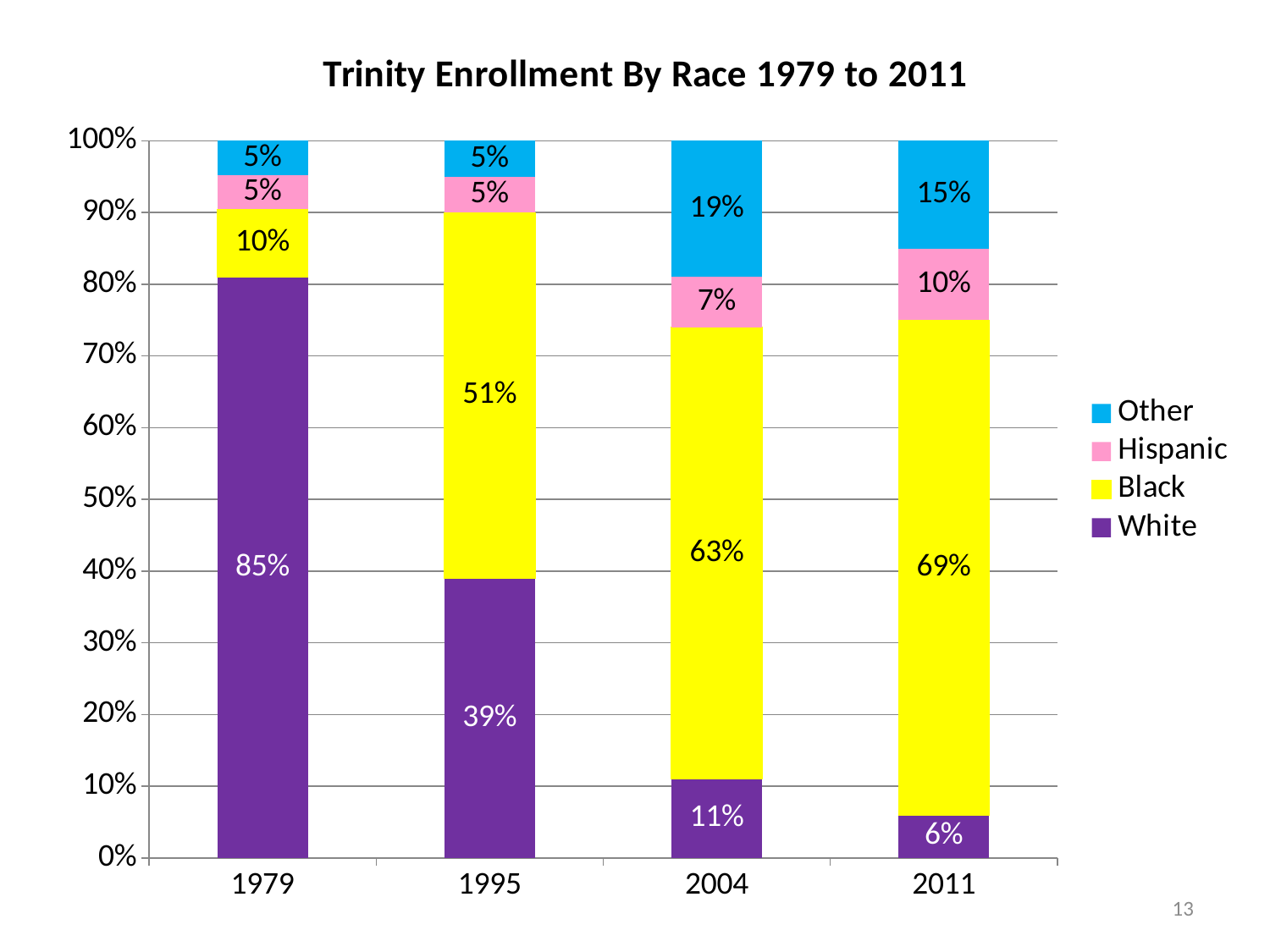
What is the White share of enrollment in 1979? 85% How many series does the legend list? 4 Which is larger in 1995, the White share or the Black share? Black What is the difference between the Black share in 2011 and the Black share in 1979? 59% What is the Other share of enrollment in 2004? 19% What is the Black share of enrollment in 2011? 69% What is the Hispanic share of enrollment in 1995? 5% In which year is the White share of enrollment highest? 1979 In which year is the White share of enrollment lowest? 2011 How many years are shown on the x axis? 4 What kind of chart is shown on the slide? Stacked bar chart Does the White share of enrollment rise or fall from 1979 to 2011? Fall